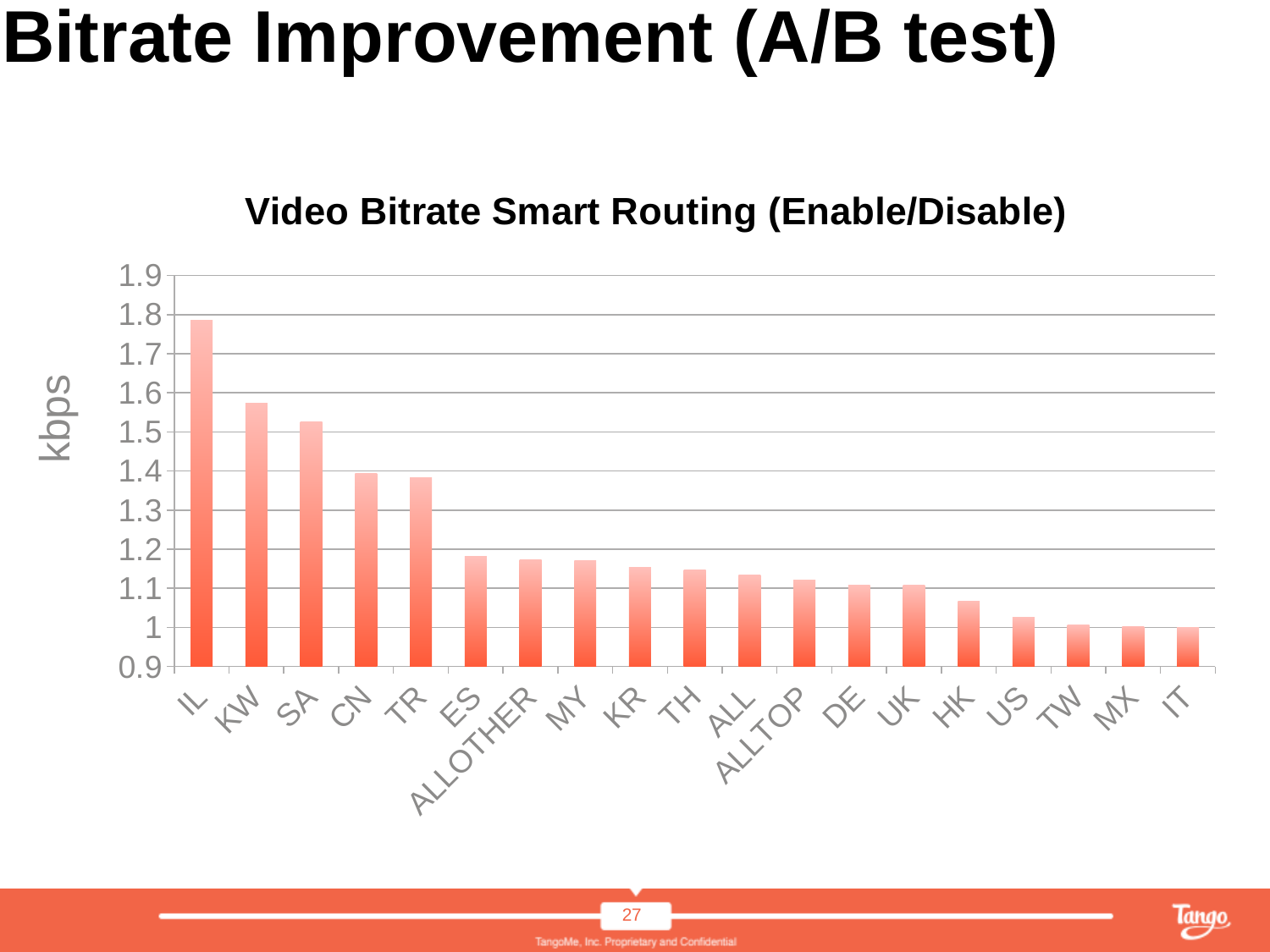
Do the values generally rise or fall moving from left to right along the x axis? Fall Is the value for ES greater or less than 1.1? greater What kind of chart is shown on the slide? Bar chart Is the value for IL greater or less than 1.7? greater Is the value for KW greater or less than 1.5? greater Which has the larger value, HK or TR? TR What is the label on the vertical axis of the chart? kbps How many categories are plotted along the x axis? 19 What is the title of the chart? Video Bitrate Smart Routing (Enable/Disable) Which has the larger value, SA or ES? SA Which category has the highest value? IL